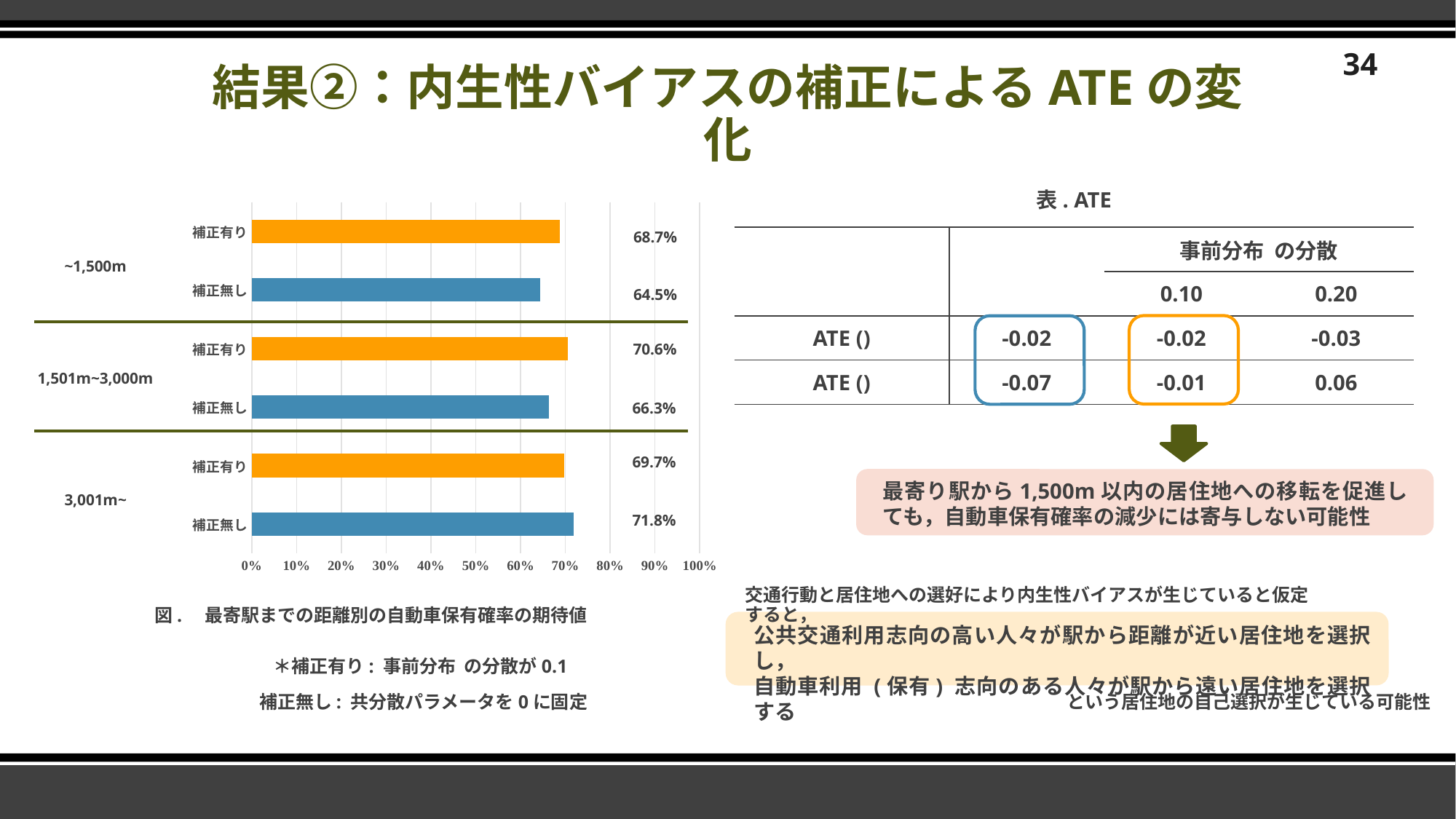
How many distance groups are shown in the chart? 3 For the 3,001m~ group, which is larger, 補正有り or 補正無し? 補正無し Is the value of 補正無し for the ~1,500m group greater or less than 70%? less What is the difference between 補正有り and 補正無し for the 1,501m~3,000m group? 4.3% What is the value of 補正有り for the ~1,500m group? 68.7% What is the value of 補正無し for the ~1,500m group? 64.5% What type of chart is shown on the left of the slide? bar chart Which bar has the lowest value in the chart? 補正無し for ~1,500m (64.5%) What is the value of 補正有り for the 1,501m~3,000m group? 70.6% Which bar has the highest value in the chart? 補正無し for 3,001m~ (71.8%) What colour are the 補正有り bars in the chart? orange What is the value of 補正無し for the 3,001m~ group? 71.8%